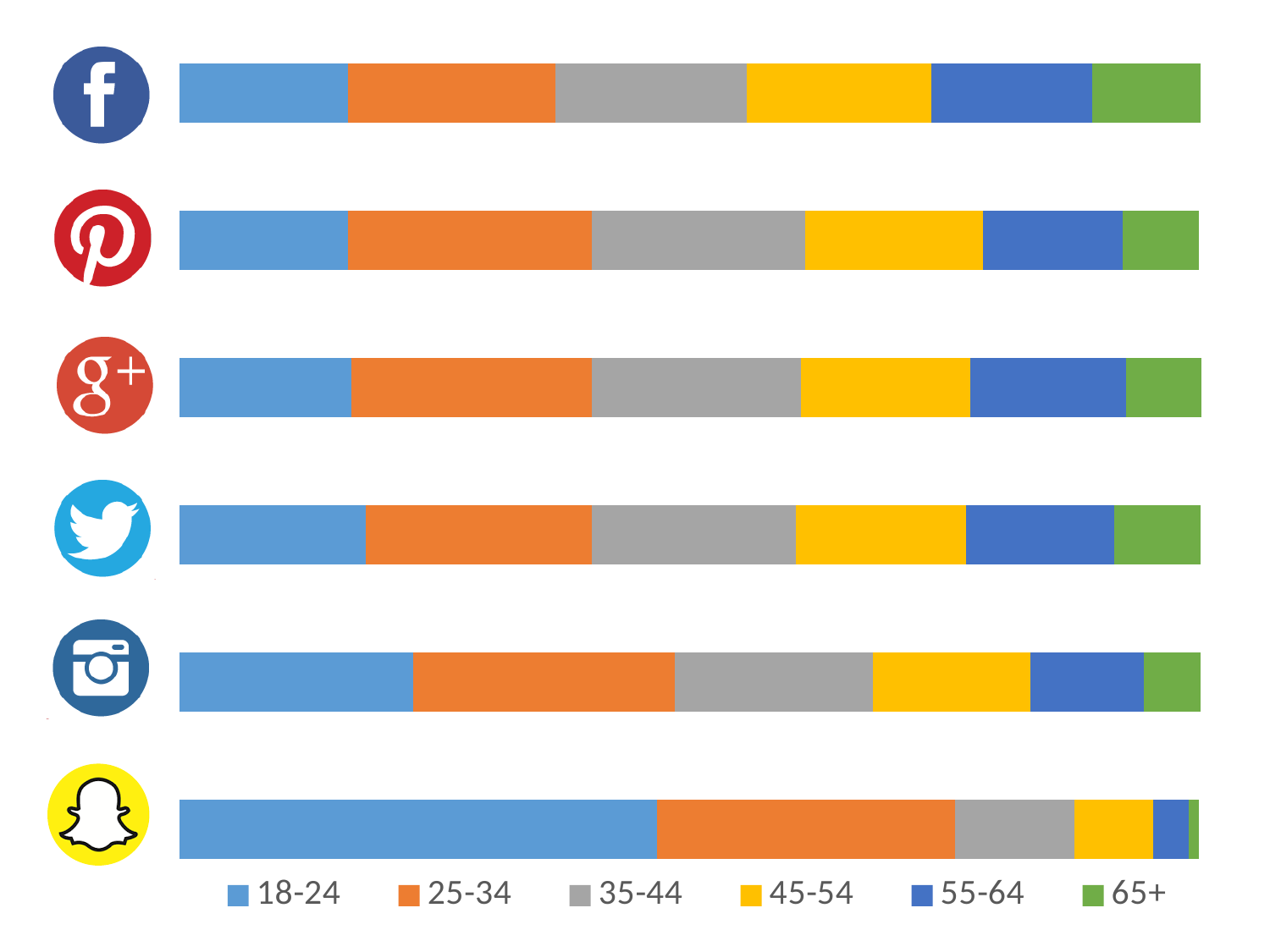
Which platform's bar has the smallest 65+ segment? Snapchat Which platform's bar has the largest 18-24 segment? Snapchat How many series does the legend list? 6 What kind of chart is shown on the slide? Stacked bar chart Which colour represents the 45-54 age group in the legend? Yellow Which platform's bar has the smallest 55-64 segment? Snapchat Is the 18-24 segment larger for Instagram or for Facebook? Instagram What is the first age group listed in the legend? 18-24 Which platform's bar has the largest 45-54 segment? Facebook Is the 18-24 segment larger for Snapchat or for Facebook? Snapchat Is the 35-44 segment larger for Facebook or for Snapchat? Facebook How many bars (social platforms) are plotted in the chart? 6